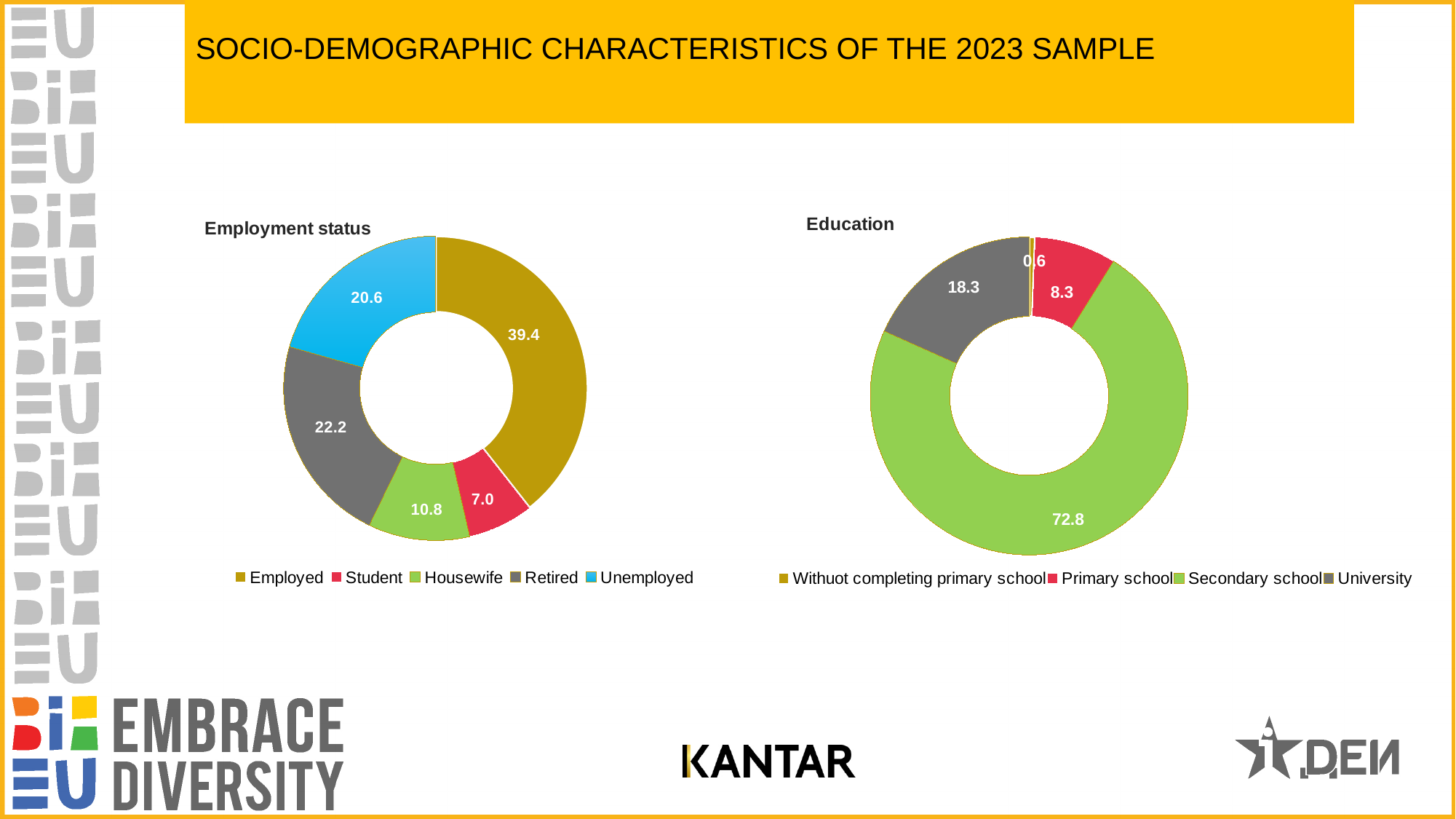
In the Education chart, what is the value for Withuot completing primary school? 0.6 In the Education chart, what is the value for Secondary school? 72.8 In the Employment status chart, what is the value for Employed? 39.4 How many entries does the legend of the Education chart list? 4 In the Employment status chart, what is the difference between the values for Retired and Unemployed? 1.6 In the Employment status chart, which category has the smallest value? Student In the Employment status chart, which category has the largest value? Employed How many categories does the Employment status chart show? 5 In the Employment status chart, which is larger, Housewife or Student? Housewife What type of chart is the Education chart? Doughnut chart In the Education chart, what is the difference between the values for University and Primary school? 10.0 In the Employment status chart, what is the value for Retired? 22.2